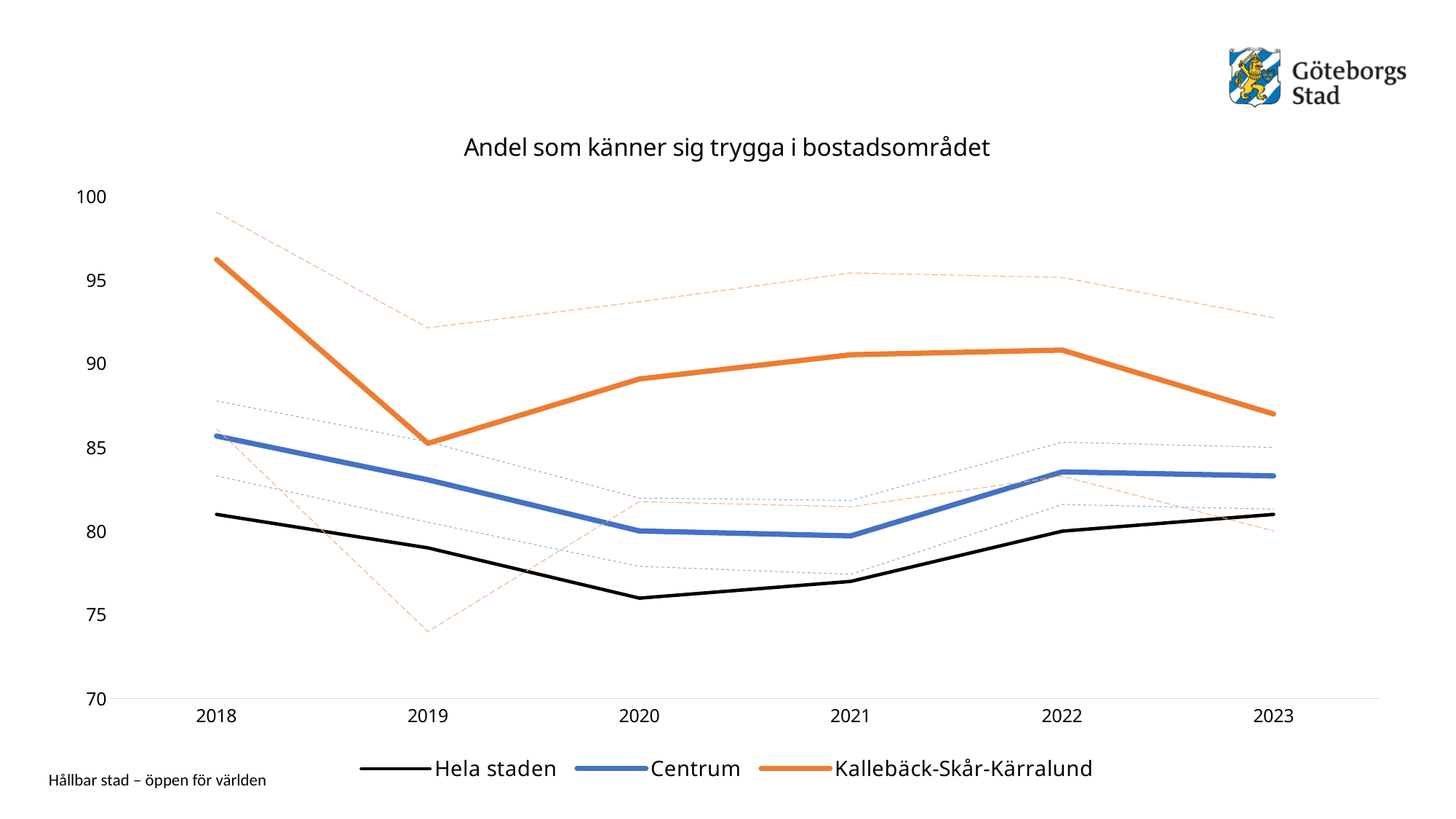
In which year is the value for Centrum highest? 2018 In which year is the value for Hela staden lowest? 2020 In which year is the value for Kallebäck-Skår-Kärralund highest? 2018 How many years are shown on the x axis? 6 What kind of chart is shown on the slide? line chart What is the title of the chart? Andel som känner sig trygga i bostadsområdet Is the value for Kallebäck-Skår-Kärralund in 2018 greater or less than 95? greater Is the value for Hela staden in 2020 greater or less than 80? less Which series has the larger value in 2023, Centrum or Kallebäck-Skår-Kärralund? Kallebäck-Skår-Kärralund Does the value for Hela staden rise or fall from 2020 to 2023? rise How many series does the legend list? 3 Which series is drawn in orange? Kallebäck-Skår-Kärralund